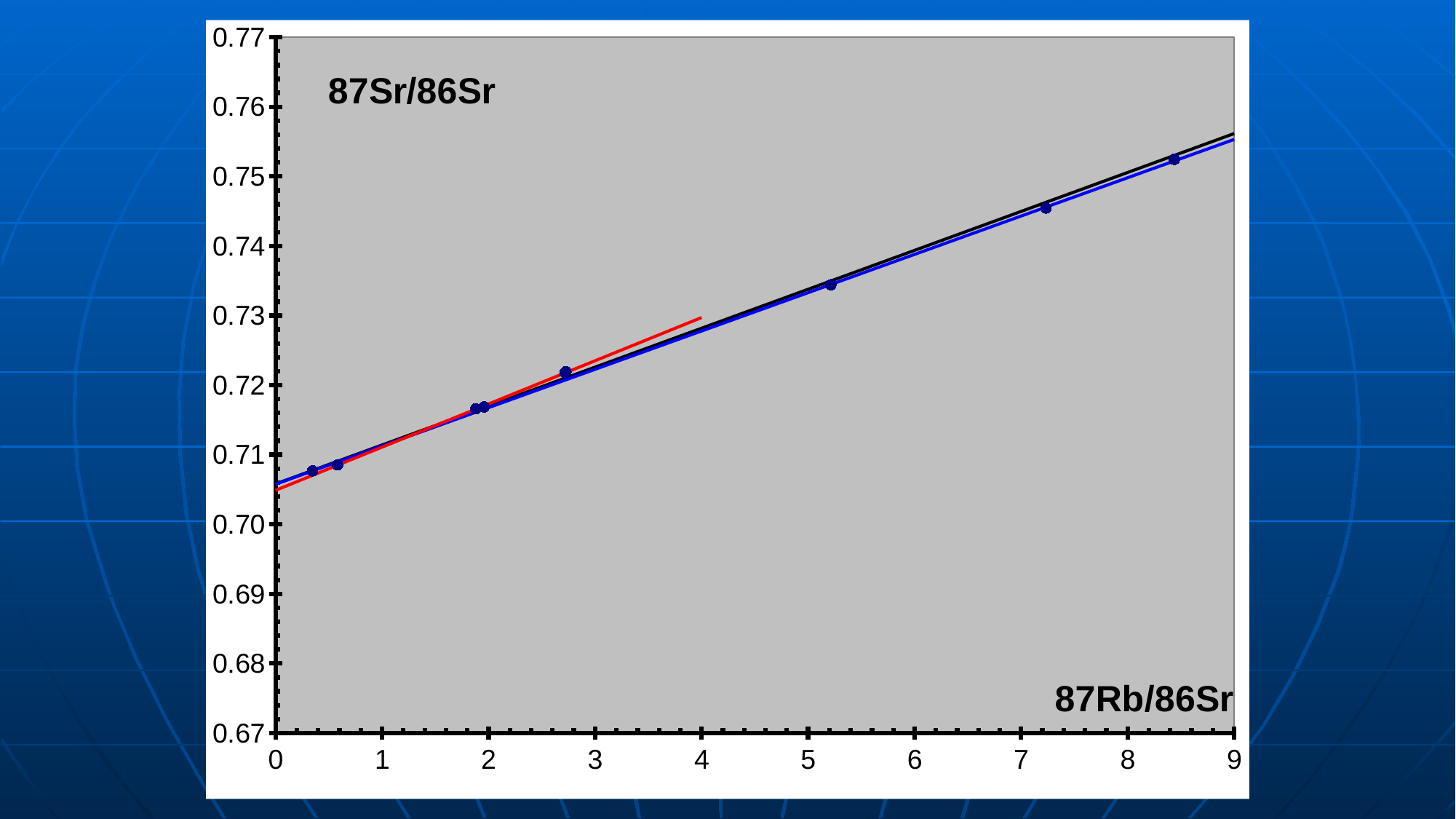
Which has the larger 87Sr/86Sr value: the data point near 87Rb/86Sr of 2.7 or the data point near 87Rb/86Sr of 5.2? the point near 5.2 What is the label on the horizontal axis of the chart? 87Rb/86Sr Is the 87Sr/86Sr value of the data point near 87Rb/86Sr of 5.2 greater or less than 0.73? greater What kind of chart is shown on the slide? scatter plot What is the highest value shown on the vertical axis of the chart? 0.77 Do the plotted 87Sr/86Sr values rise or fall as 87Rb/86Sr increases along the x axis? rise Is the 87Sr/86Sr value of the rightmost data point (near 87Rb/86Sr of 8.4) greater or less than 0.75? greater Is the 87Sr/86Sr value of the data point near 87Rb/86Sr of 7.2 greater or less than 0.74? greater What is the label on the vertical axis of the chart? 87Sr/86Sr Which data point has the highest 87Sr/86Sr value: the one at the far left or the one at the far right of the chart? the one at the far right